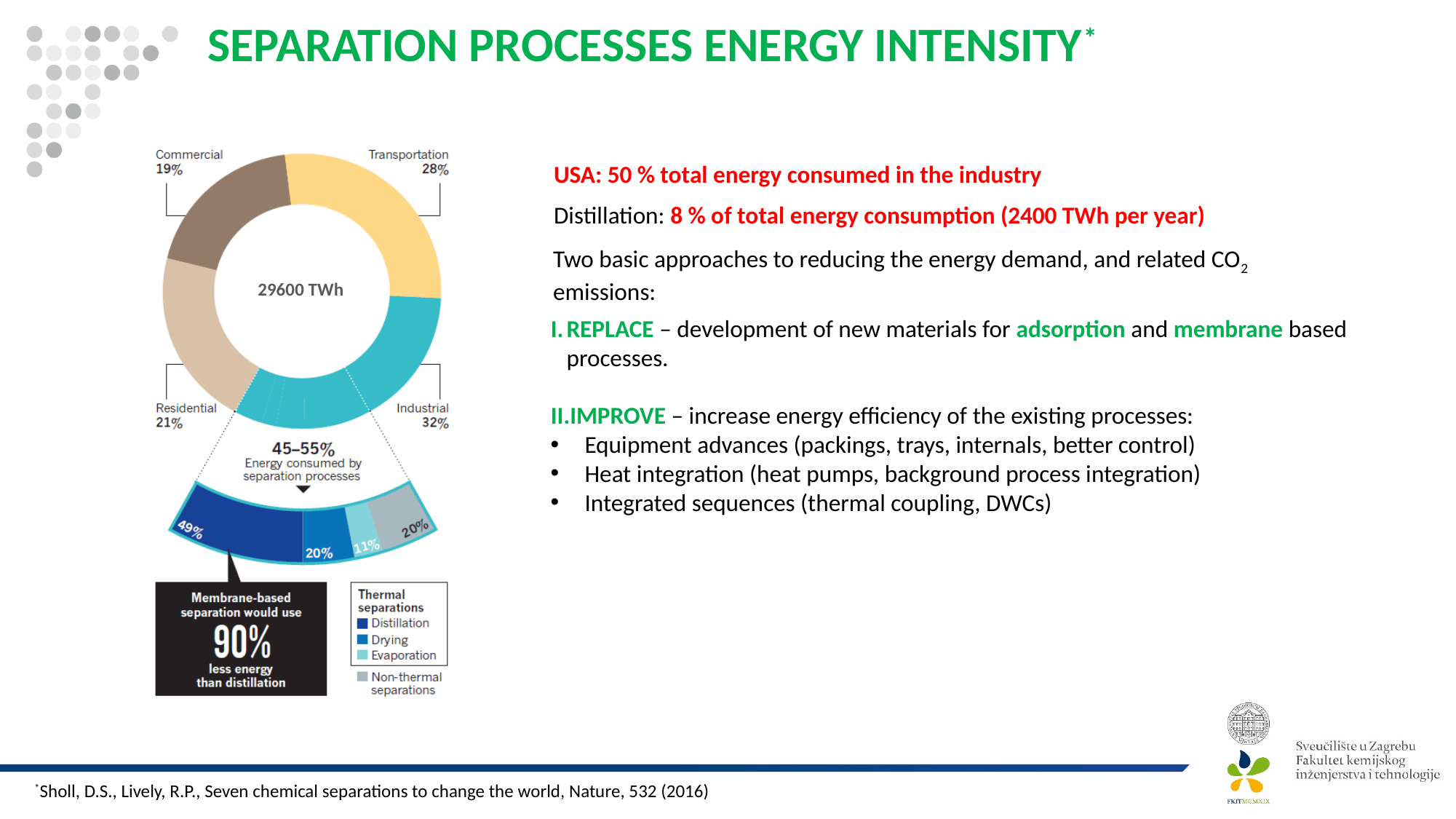
In the donut chart, what share of energy is consumed by the Commercial sector? 19% What range of energy is stated to be consumed by separation processes in the industrial sector? 45–55% In the separation processes bar below the donut, what share is attributed to Evaporation? 11% In the donut chart, what is the difference in percentage points between the Transportation and Residential shares? 7 In the donut chart, which sector has the smallest share of energy consumption? Commercial In the donut chart, which sector has a larger share, Transportation or Residential? Transportation What total energy value is printed in the centre of the donut chart? 29600 TWh In the donut chart, what share of energy is consumed by the Industrial sector? 32% In the separation processes bar below the donut, what is the difference in percentage points between Distillation and Drying? 29 How many sectors are shown in the donut chart? 4 In the separation processes bar below the donut, what share is attributed to Distillation? 49% In the donut chart, which sector has the largest share of energy consumption? Industrial